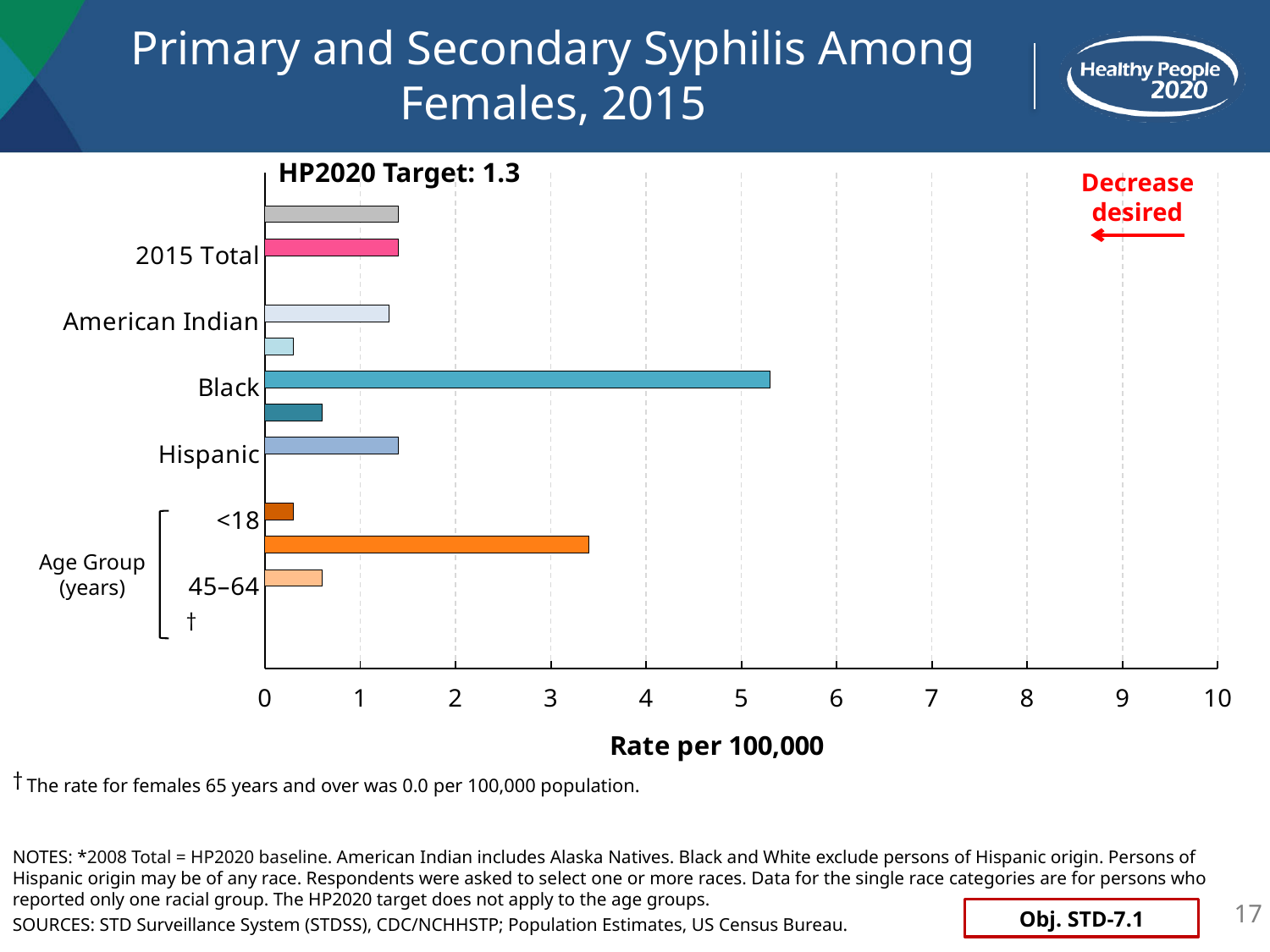
Is the 2015 Total rate greater or less than 2 per 100,000? less Is the rate for Hispanic females greater or less than 1 per 100,000? greater Which labeled group has the highest rate of primary and secondary syphilis among females in 2015? Black Is the rate for American Indian females greater or less than 1 per 100,000? greater Which is larger, the rate for Black females or the rate for Hispanic females? Black What is the title of the x axis? Rate per 100,000 Which is larger, the rate for females aged <18 or the rate for females aged 45–64? 45–64 What is the HP2020 target shown on the chart? 1.3 What kind of chart is shown on the slide? bar chart